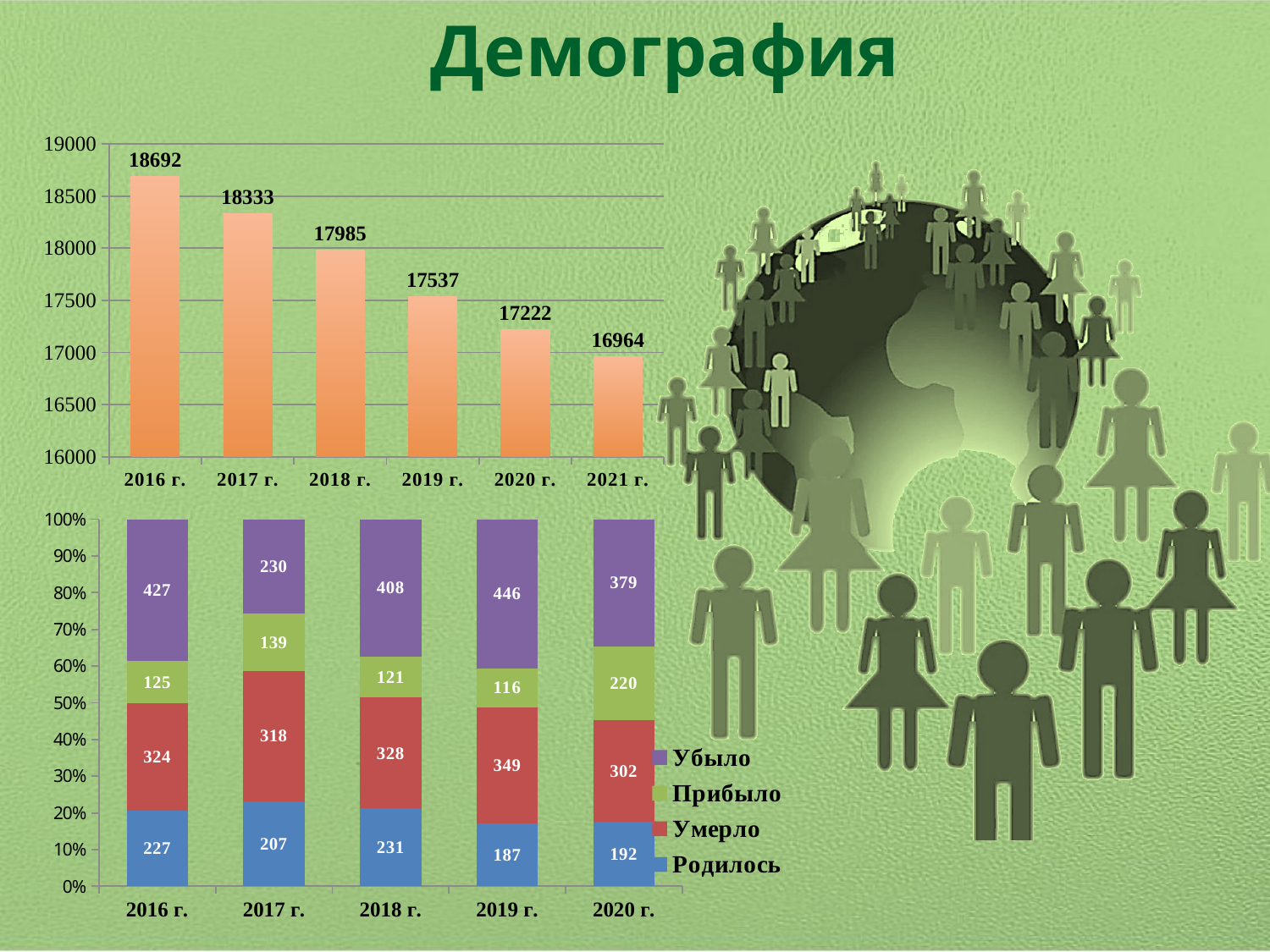
In the top chart, which year has the highest value? 2016 г. What kind of chart is the bottom chart? stacked bar chart In the top chart, what is the value for 2018 г.? 17985 In the bottom chart, which year has the highest value of Прибыло? 2020 г. In the top chart, what is the difference between the values for 2016 г. and 2021 г.? 1728 In the bottom chart, what is the value of Умерло for 2019 г.? 349 In the top chart, how many years are shown? 6 In the top chart, do the values rise or fall from 2016 г. to 2021 г.? fall In the bottom chart, how many series does the legend list? 4 In the top chart, which year has the lowest value? 2021 г. In the bottom chart, what is the value of Родилось for 2017 г.? 207 In the bottom chart, which is larger for 2018 г.: Убыло or Умерло? Убыло